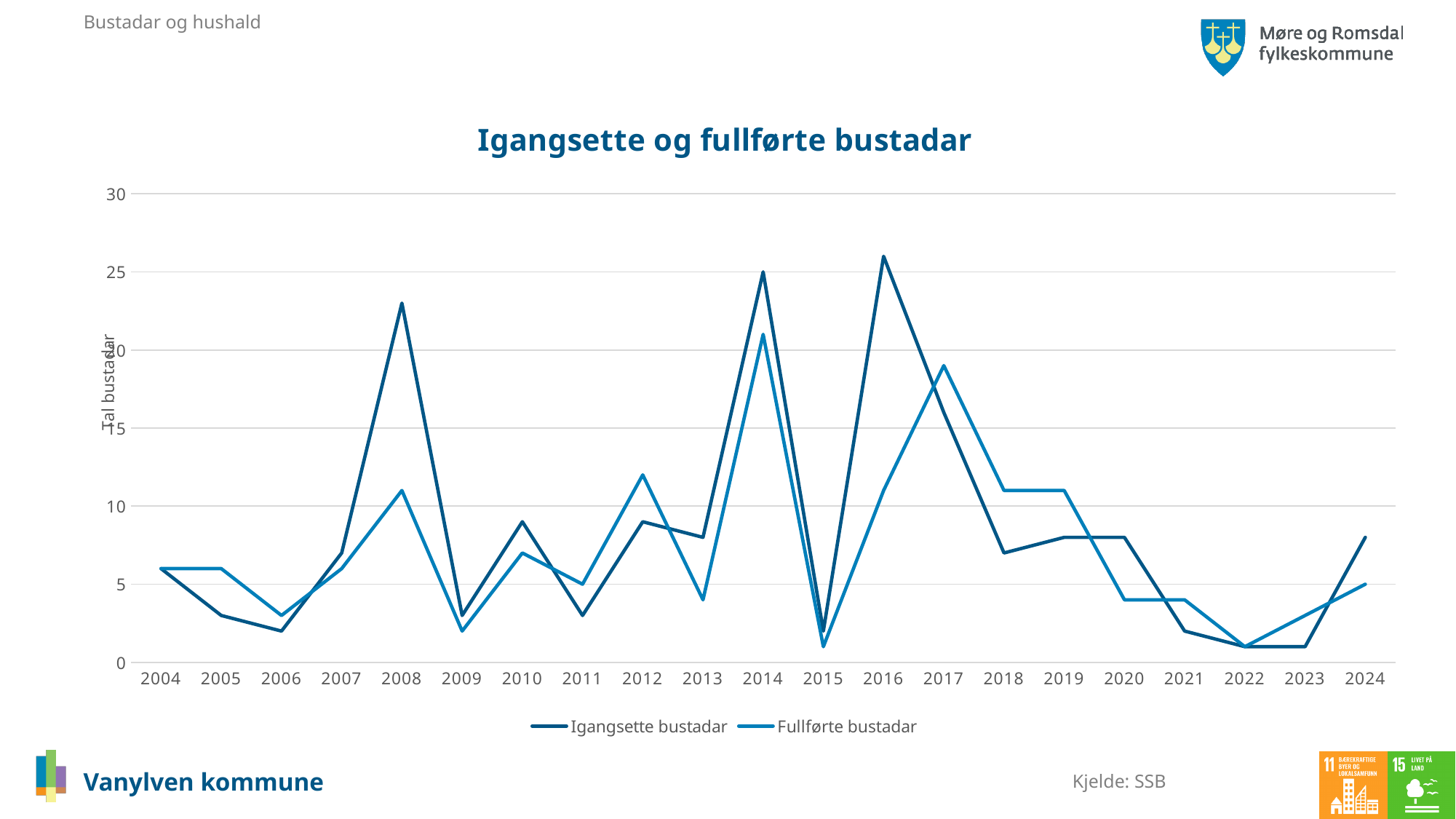
In which year is Fullførte bustadar highest? 2014 What kind of chart is shown on the slide? Line chart How many series does the legend list? 2 How many years are shown on the x axis? 21 Is the value for Igangsette bustadar in 2021 greater or less than 5? less Is the value for Fullførte bustadar in 2017 greater or less than 20? less What is the value for Fullførte bustadar in 2024? 5 Does Fullførte bustadar rise or fall from 2017 to 2022? Fall Is the value for Igangsette bustadar in 2008 greater or less than 20? greater What is the value for Igangsette bustadar in 2014? 25 In 2017, which series has the larger value, Igangsette bustadar or Fullførte bustadar? Fullførte bustadar In which year is Igangsette bustadar highest? 2016